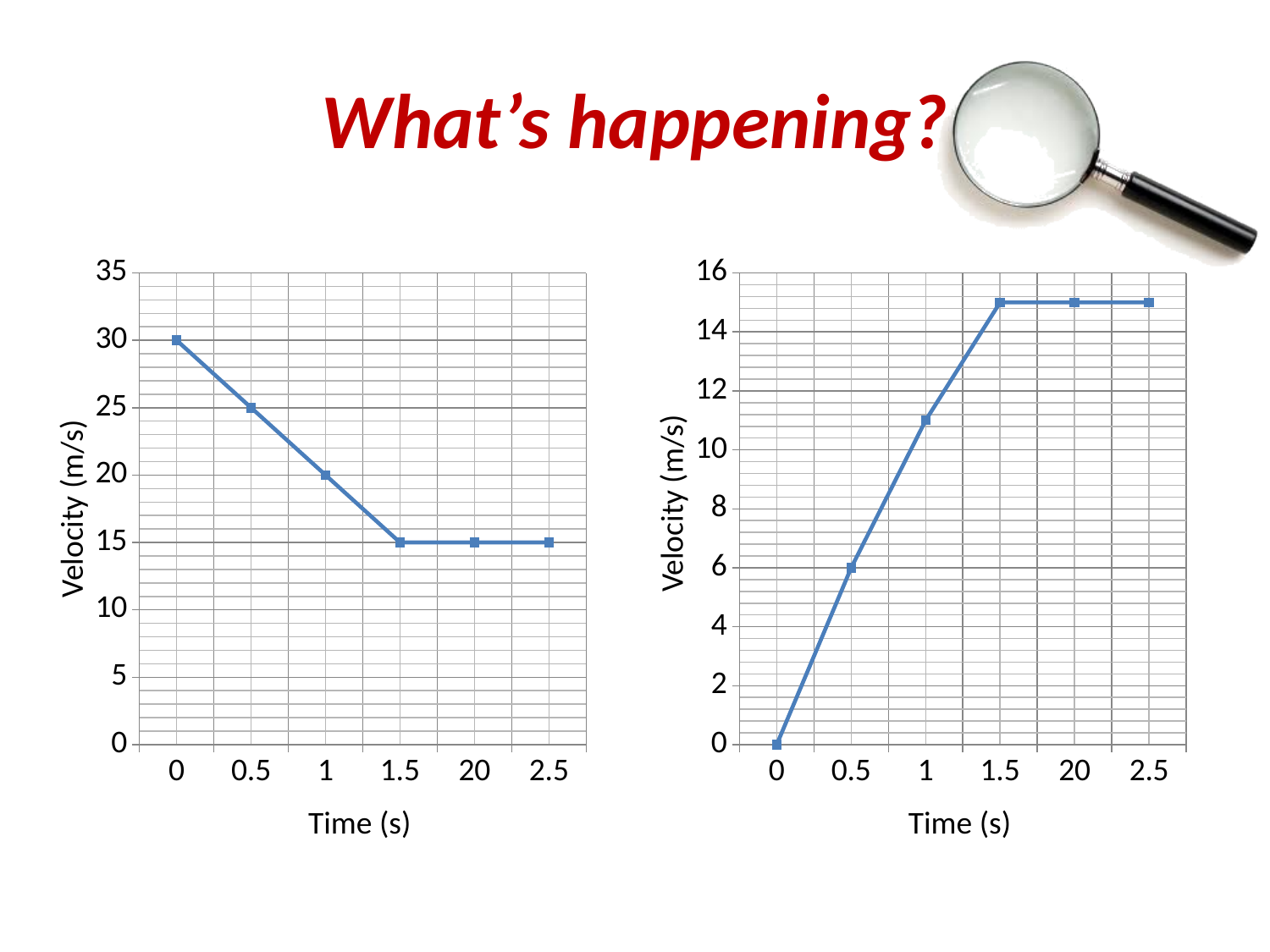
On the left chart, how many data points are plotted? 6 What type of chart is the left chart? line chart On the left chart, what is the velocity at time 0? 30 On the right chart, does the velocity rise or fall between time 0 and time 1.5? rise On the right chart, what is the velocity at time 0.5? 6 On the left chart, what is the difference in velocity between time 0 and time 0.5? 5 On the right chart, what is the velocity at time 0? 0 On the left chart, what is the velocity at time 1? 20 On the left chart, does the velocity rise or fall between time 0 and time 1.5? fall What is the y-axis label on the right chart? Velocity (m/s) On the left chart, what is the velocity at time 1.5? 15 On the right chart, is the velocity at time 1 greater or less than 10? greater